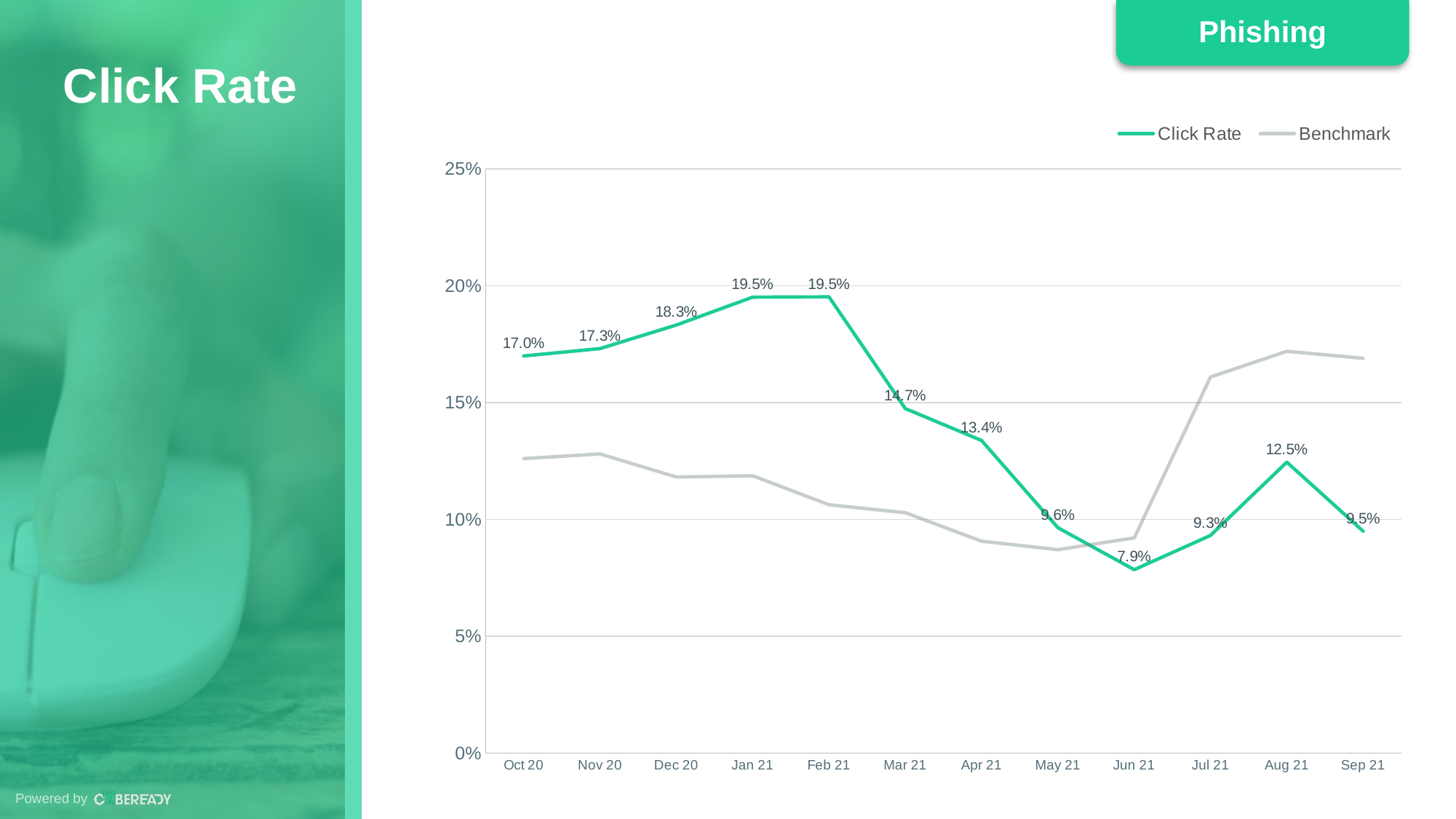
What kind of chart is shown on the slide? Line chart Which month has the lowest Click Rate? Jun 21 Is the Benchmark value for Jul 21 greater or less than 15%? greater Which is larger, the Click Rate in Oct 20 or in Sep 21? Oct 20 How many months are shown on the x axis? 12 What is the Click Rate for Aug 21? 12.5% What is the Click Rate for Jan 21? 19.5% How many series does the legend list? 2 What is the difference between the Click Rate in Feb 21 and Mar 21? 4.8% Is the Benchmark value for May 21 greater or less than 10%? less Does the Click Rate rise or fall from Feb 21 to Jun 21? Fall What is the Click Rate for Jun 21? 7.9%